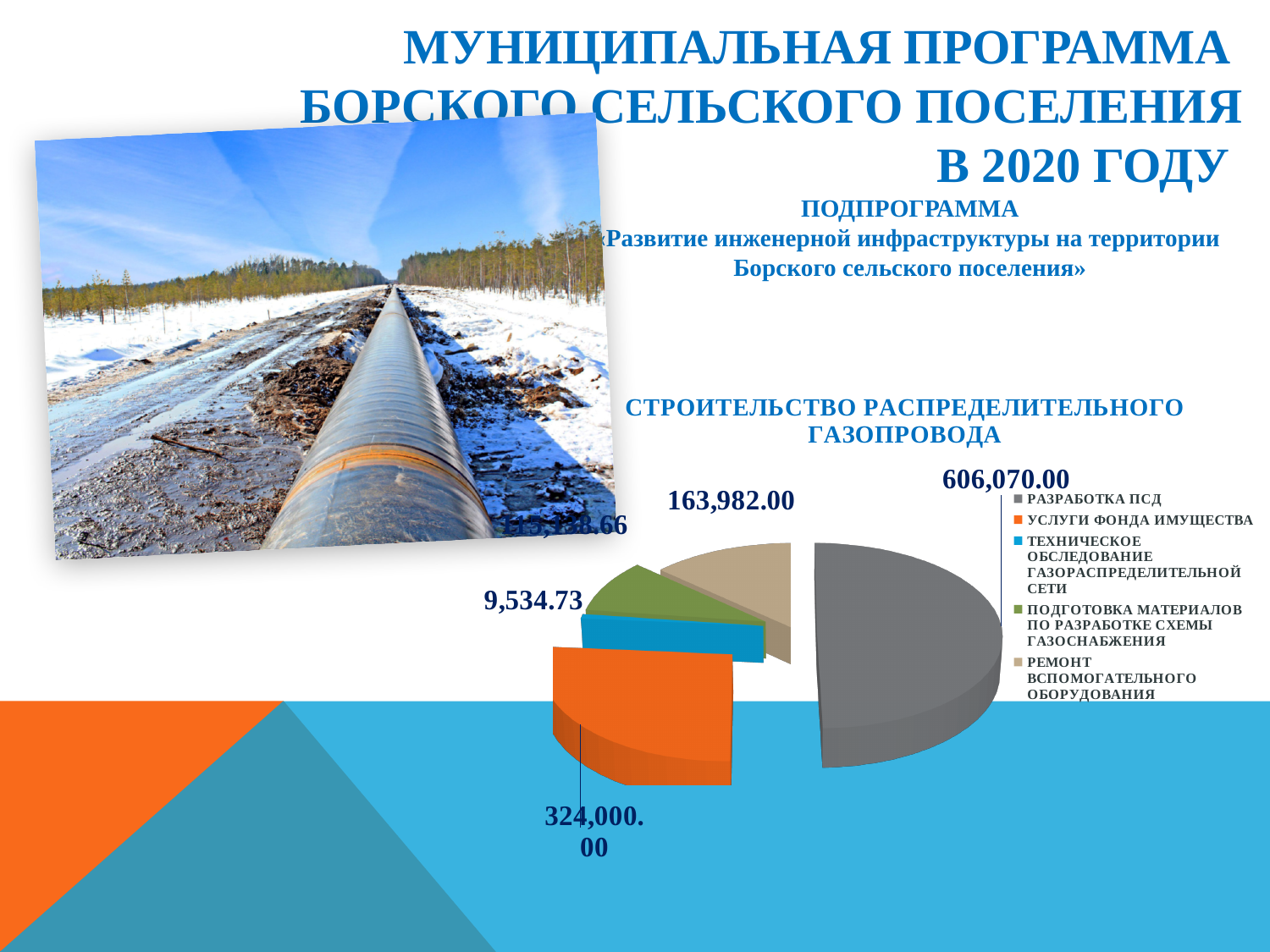
Which category has the largest slice in the pie chart? РАЗРАБОТКА ПСД What is the value for УСЛУГИ ФОНДА ИМУЩЕСТВА in the pie chart? 324,000.00 Which is larger in the pie chart: УСЛУГИ ФОНДА ИМУЩЕСТВА or РЕМОНТ ВСПОМОГАТЕЛЬНОГО ОБОРУДОВАНИЯ? УСЛУГИ ФОНДА ИМУЩЕСТВА What is the difference between the values for РАЗРАБОТКА ПСД and УСЛУГИ ФОНДА ИМУЩЕСТВА in the pie chart? 282,070.00 What is the title of the pie chart? СТРОИТЕЛЬСТВО РАСПРЕДЕЛИТЕЛЬНОГО ГАЗОПРОВОДА What is the value for ТЕХНИЧЕСКОЕ ОБСЛЕДОВАНИЕ ГАЗОРАСПРЕДЕЛИТЕЛЬНОЙ СЕТИ in the pie chart? 9,534.73 What kind of chart is shown on the slide? pie chart What colour is the slice for УСЛУГИ ФОНДА ИМУЩЕСТВА in the pie chart? orange How many categories does the legend of the pie chart list? 5 Which category has the smallest slice in the pie chart? ТЕХНИЧЕСКОЕ ОБСЛЕДОВАНИЕ ГАЗОРАСПРЕДЕЛИТЕЛЬНОЙ СЕТИ What is the value for РАЗРАБОТКА ПСД in the pie chart? 606,070.00 What is the value for РЕМОНТ ВСПОМОГАТЕЛЬНОГО ОБОРУДОВАНИЯ in the pie chart? 163,982.00